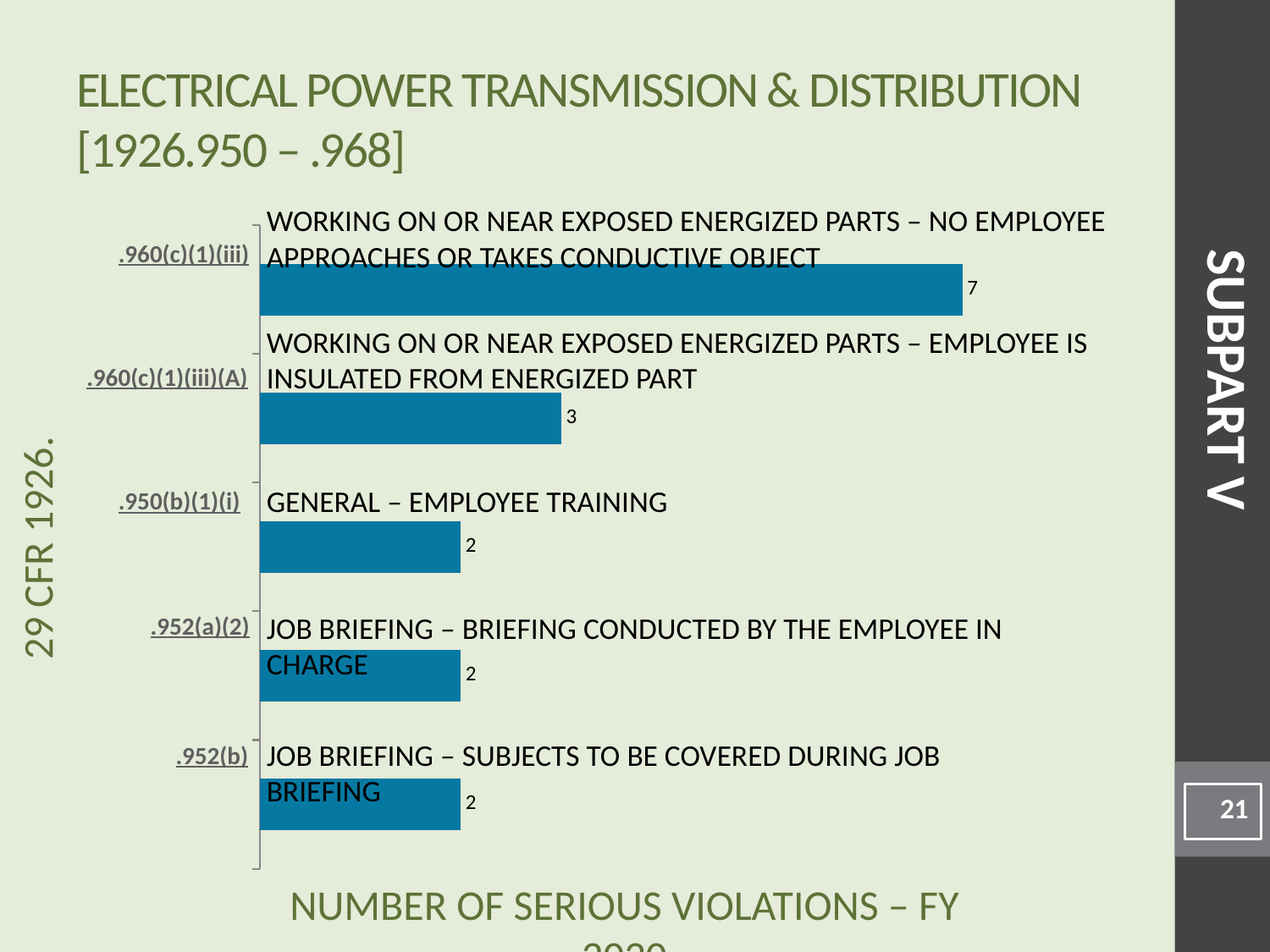
Which category has the highest number of serious violations? .960(c)(1)(iii) What is the difference between the values for .960(c)(1)(iii) and .960(c)(1)(iii)(A)? 4 What is the value for .950(b)(1)(i), General – Employee Training? 2 What is the value for .952(b)? 2 How many serious violations are shown for .960(c)(1)(iii)(A)? 3 How many categories are plotted in the chart? 5 What is the title of the chart? Number of Serious Violations – FY 2020 What is the total number of serious violations across all five categories? 16 What kind of chart is shown on the slide? Bar chart What is the difference between the values for .960(c)(1)(iii)(A) and .952(a)(2)? 1 Which is larger, the value for .960(c)(1)(iii)(A) or the value for .950(b)(1)(i)? .960(c)(1)(iii)(A) How many serious violations are shown for .960(c)(1)(iii)? 7